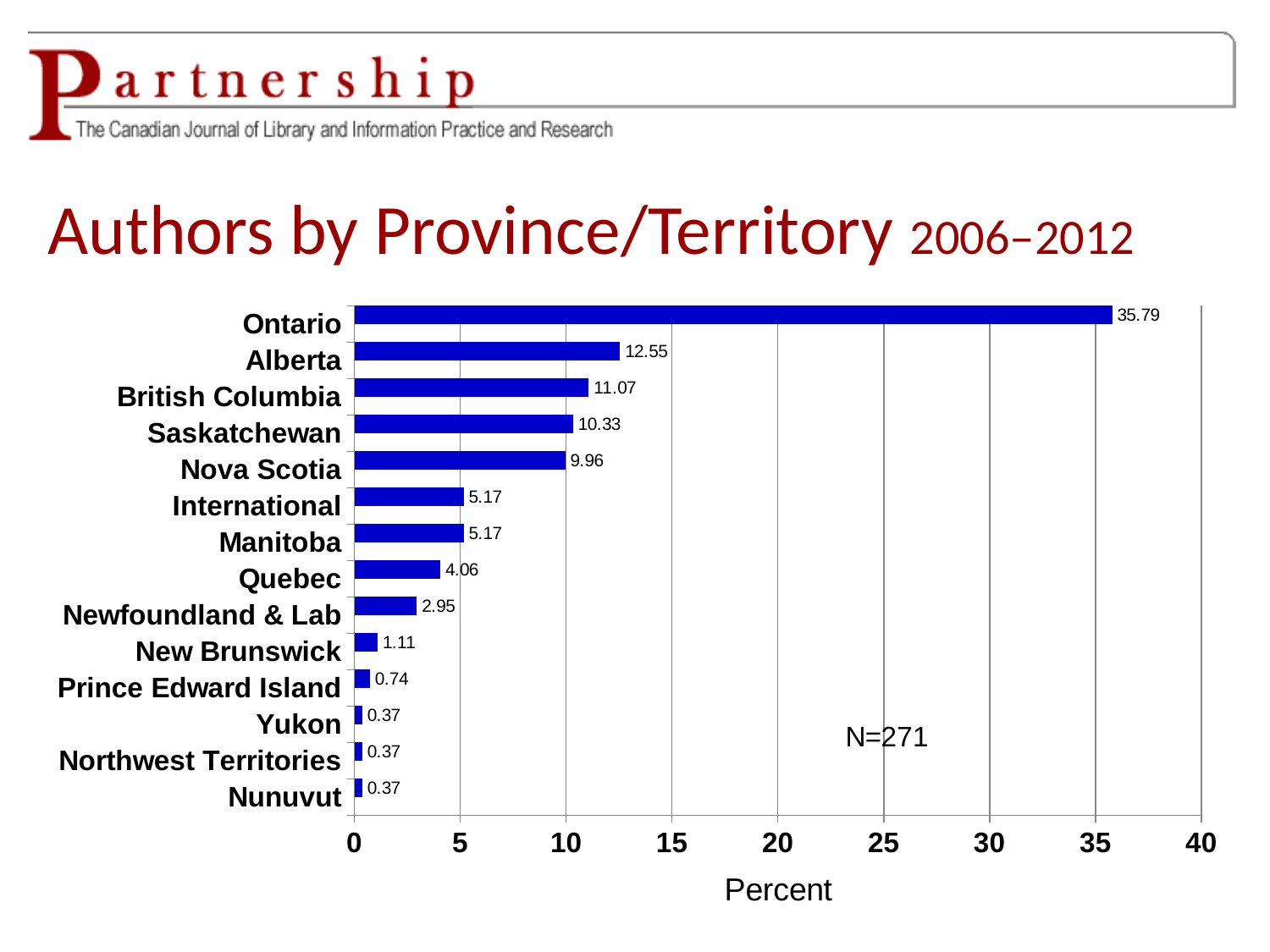
Is the value for Ontario greater or less than 35? greater How many categories are shown on the chart? 14 What is the value for Saskatchewan? 10.33 Is the value for Nova Scotia greater or less than 10? less Which is larger, the value for Quebec or the value for Manitoba? Manitoba What is the label on the horizontal axis of the chart? Percent What kind of chart is shown on the slide? Bar chart What is the value for Newfoundland & Lab? 2.95 What is the difference between the values for Ontario and Nova Scotia? 25.83 What is the difference between the values for Alberta and British Columbia? 1.48 What is the value for Ontario? 35.79 Which province or territory has the highest value? Ontario